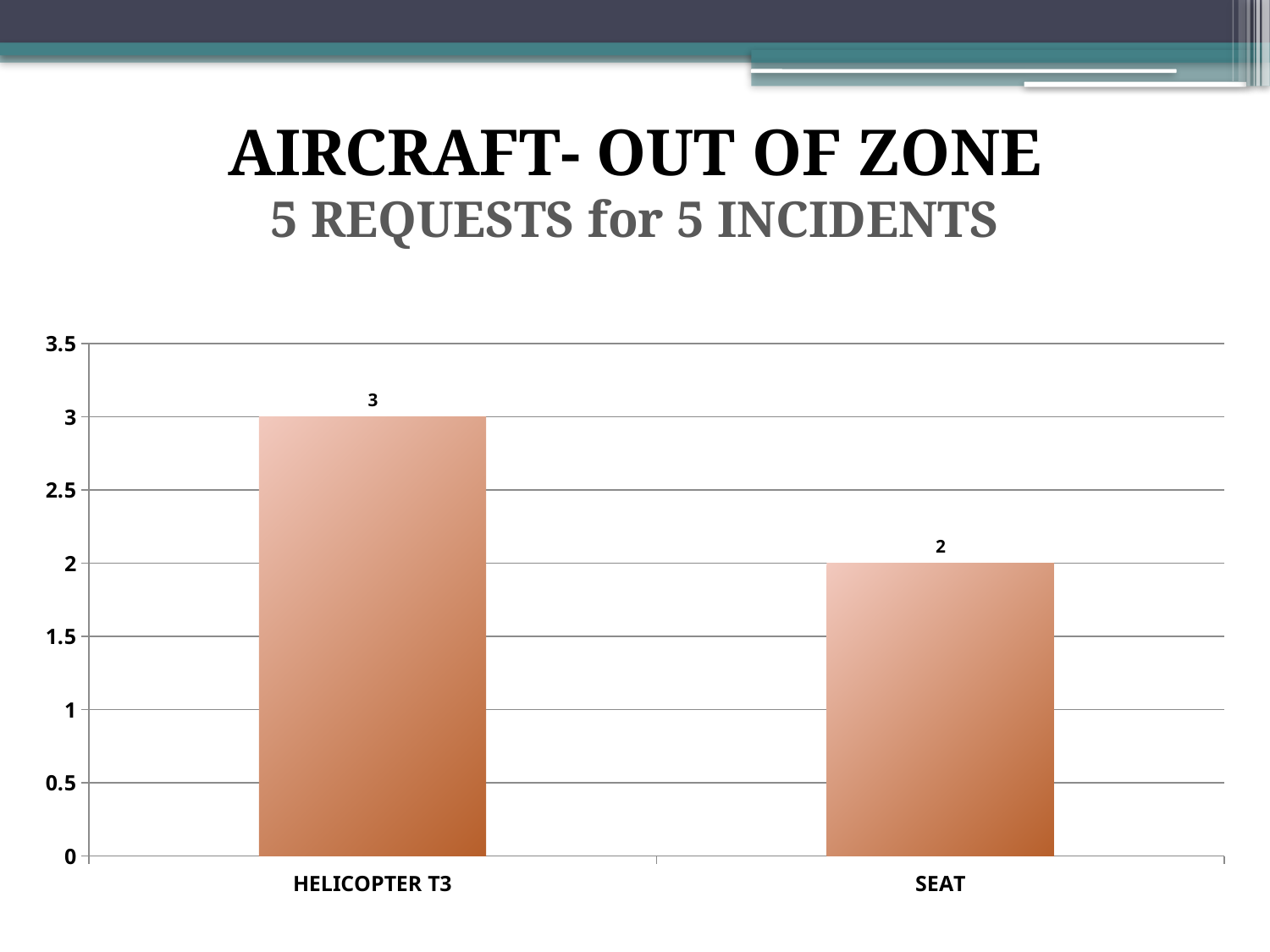
Is the value for HELICOPTER T3 greater or less than 2.5? greater Which category has the lowest value? SEAT What is the maximum value shown on the y axis? 3.5 What is the total of the values for HELICOPTER T3 and SEAT? 5 What is the value for HELICOPTER T3? 3 Is the value for SEAT greater or less than 2.5? less Which category has the highest value? HELICOPTER T3 How many categories are shown on the x axis? 2 What is the difference between the values for HELICOPTER T3 and SEAT? 1 Which is larger, the value for HELICOPTER T3 or the value for SEAT? HELICOPTER T3 What is the value for SEAT? 2 What kind of chart is shown on the slide? bar chart